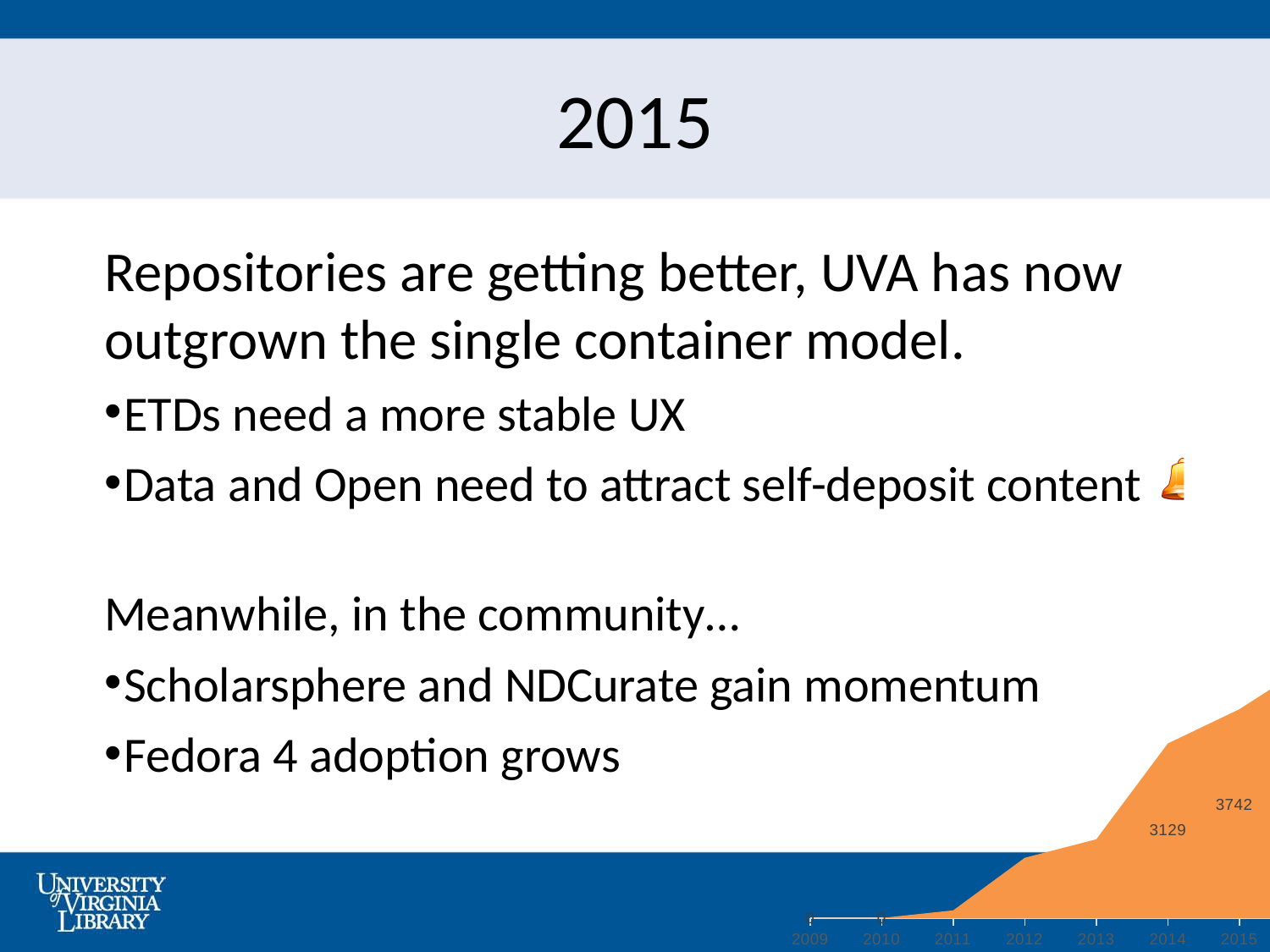
In the bottom-right chart, what is the difference between the 2015 value and the 2014 value? 613 In the bottom-right chart, which year has the highest value? 2015 In the bottom-right chart, what is the first year shown on the x axis? 2009 In the bottom-right chart, what is the value labelled for 2014? 3129 In the bottom-right chart, do the values rise or fall from 2009 to 2015? rise In the bottom-right chart, which year has the lowest value? 2009 and 2010 (tied at 0) In the bottom-right chart, how many years are labelled on the x axis? 7 In the bottom-right chart, which year has the larger value, 2014 or 2015? 2015 What kind of chart is shown in the bottom-right corner of the slide? area chart In the bottom-right chart, what is the value labelled for 2015? 3742 What colour is the filled area in the bottom-right chart? orange